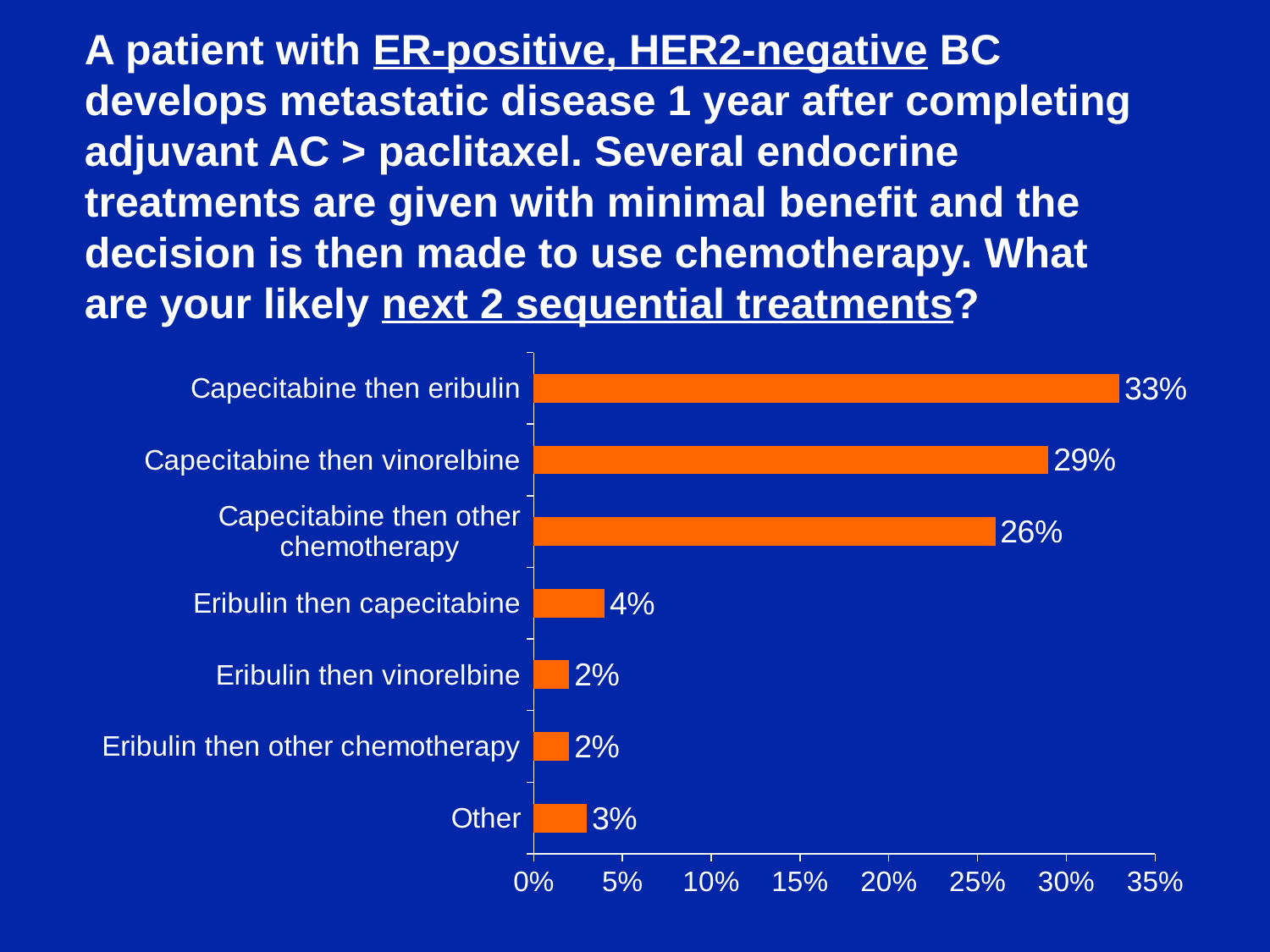
What is the value for Capecitabine then other chemotherapy? 26% What is the value for Capecitabine then vinorelbine? 29% What kind of chart is shown on the slide? Bar chart What percentage of respondents chose Capecitabine then eribulin? 33% How many treatment sequence categories are shown in the chart? 7 Which is larger, Eribulin then capecitabine or Other? Eribulin then capecitabine What is the difference between Capecitabine then other chemotherapy and Eribulin then capecitabine? 22% What is the value for Other? 3% Is the value for Capecitabine then vinorelbine greater or less than 25%? greater What is the value for Eribulin then capecitabine? 4% Which treatment sequence has the highest value? Capecitabine then eribulin What is the difference between Capecitabine then eribulin and Capecitabine then vinorelbine? 4%